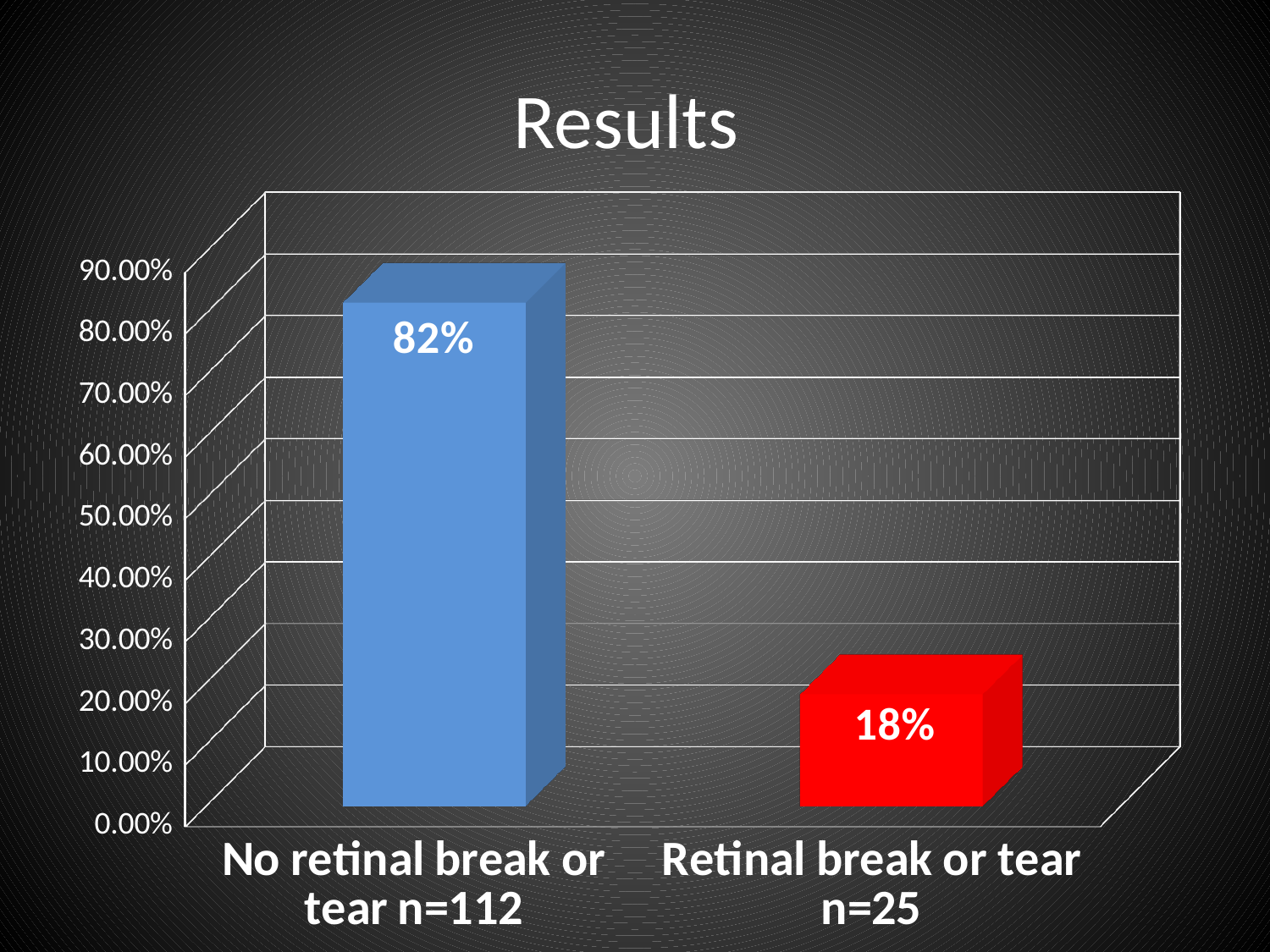
How many categories are shown in the chart? 2 Is the value for "Retinal break or tear n=25" greater or less than 20.00%? less What is the value for "Retinal break or tear n=25"? 18% Which is larger: the value for "No retinal break or tear n=112" or "Retinal break or tear n=25"? No retinal break or tear n=112 What is the value for "No retinal break or tear n=112"? 82% What is the difference between the values for "No retinal break or tear n=112" and "Retinal break or tear n=25"? 64% Which category has the highest value? No retinal break or tear n=112 Is the value for "No retinal break or tear n=112" greater or less than 80.00%? greater What is the title of the slide? Results What kind of chart is shown on the slide? Bar chart What colour is the bar for "Retinal break or tear n=25"? Red Which category has the lowest value? Retinal break or tear n=25